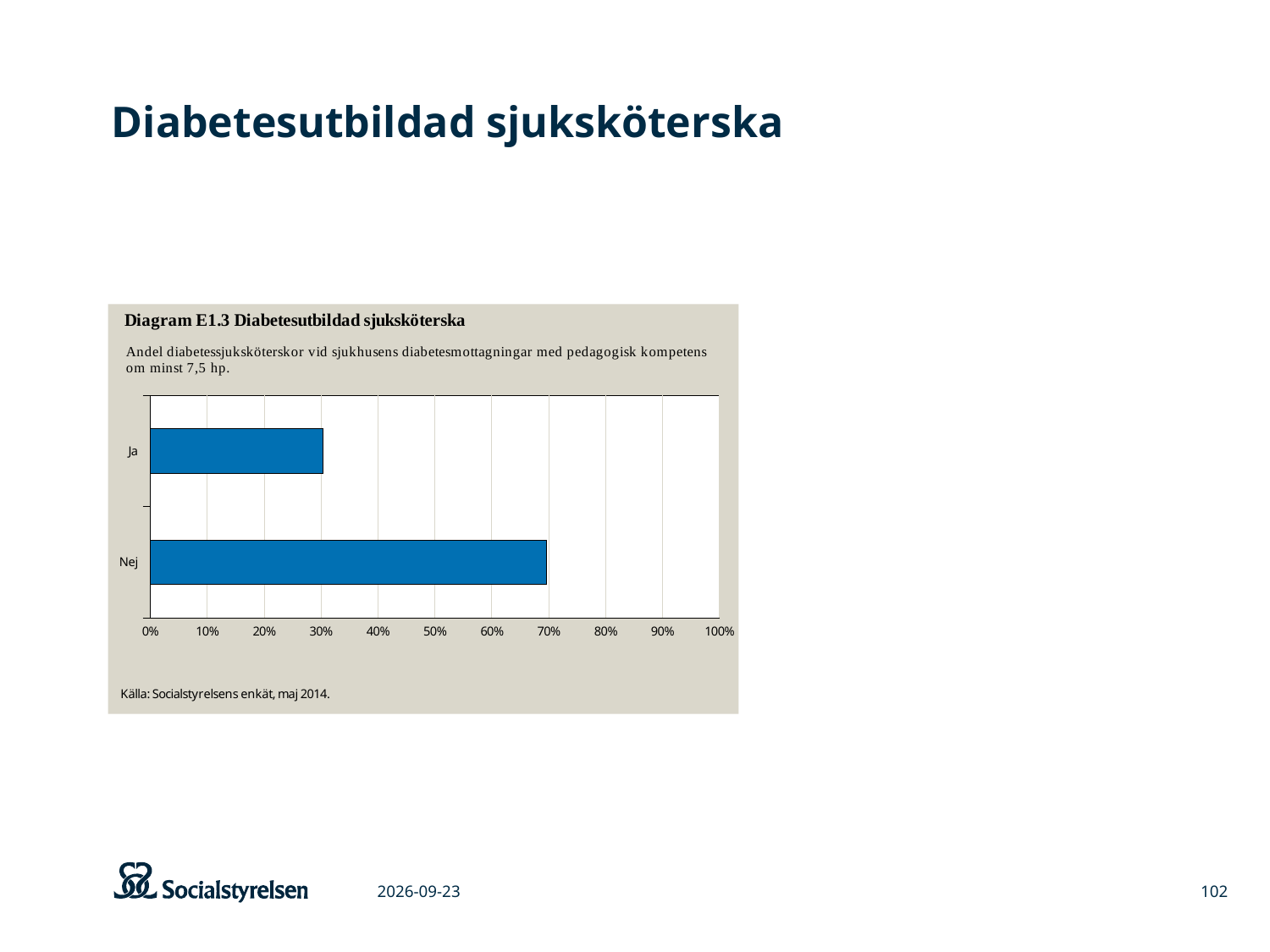
What kind of chart is shown on the slide? bar chart Which is larger, the value for Ja or the value for Nej? Nej Which category has the lowest value in the chart? Ja How many categories are plotted in the chart? 2 Is the value for Ja greater or less than 20%? greater Is the value for Ja greater or less than 40%? less What is the highest value shown on the chart's x axis? 100% Is the value for Nej greater or less than 60%? greater Which category has the highest value in the chart? Nej What is the title of the diagram shown in the chart box? Diagram E1.3 Diabetesutbildad sjuksköterska